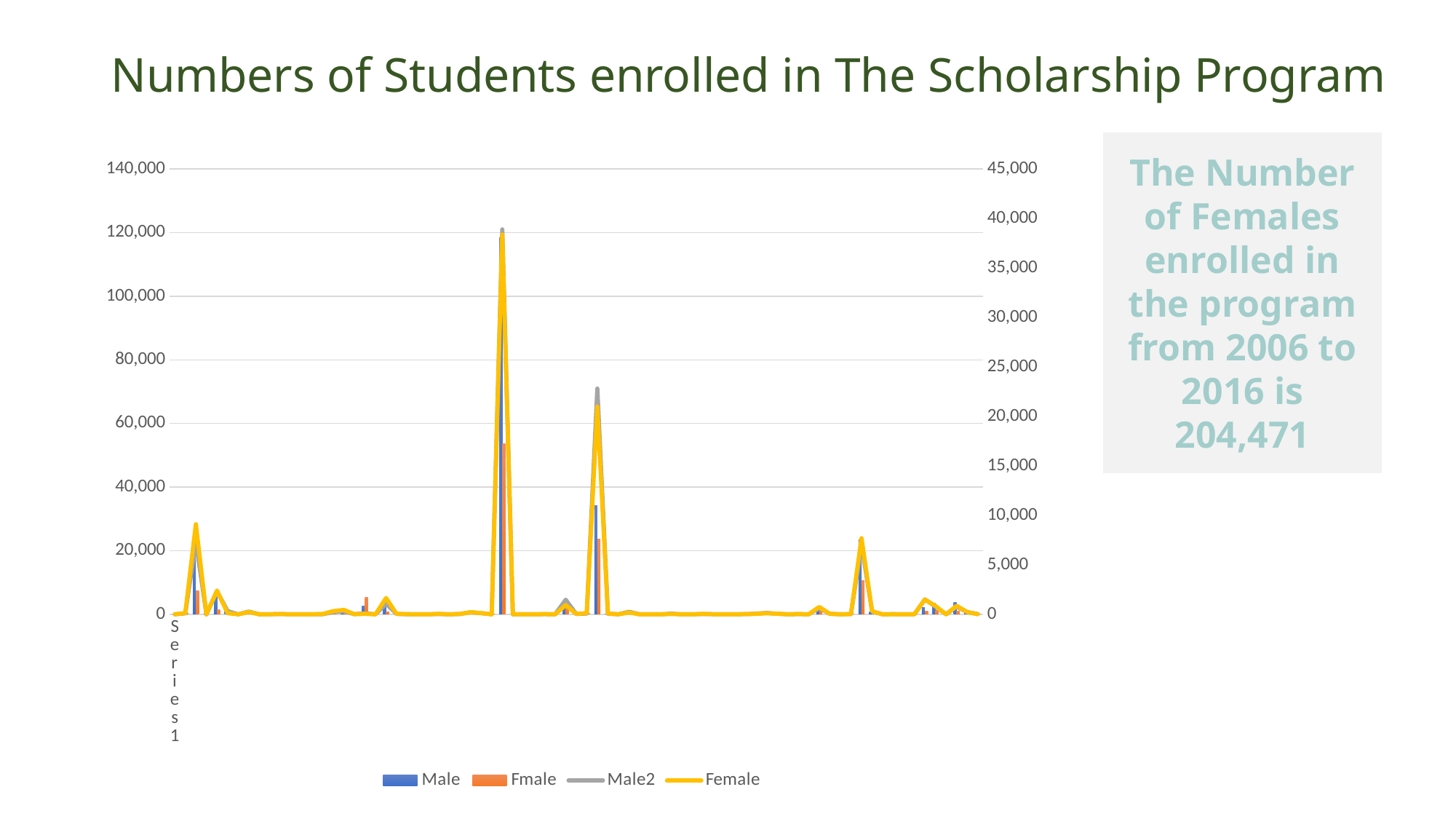
Is the Male bar value for the category labelled Series1 greater or less than 20,000? less What is the title of the slide containing the chart? Numbers of Students enrolled in The Scholarship Program Is the Female line value for the category labelled Series1 greater or less than 5,000 on the right axis? less What kind of chart is shown on the slide? Combined bar and line chart How many series does the chart legend list? 4 What are the names of the series listed in the chart legend? Male, Fmale, Male2, Female